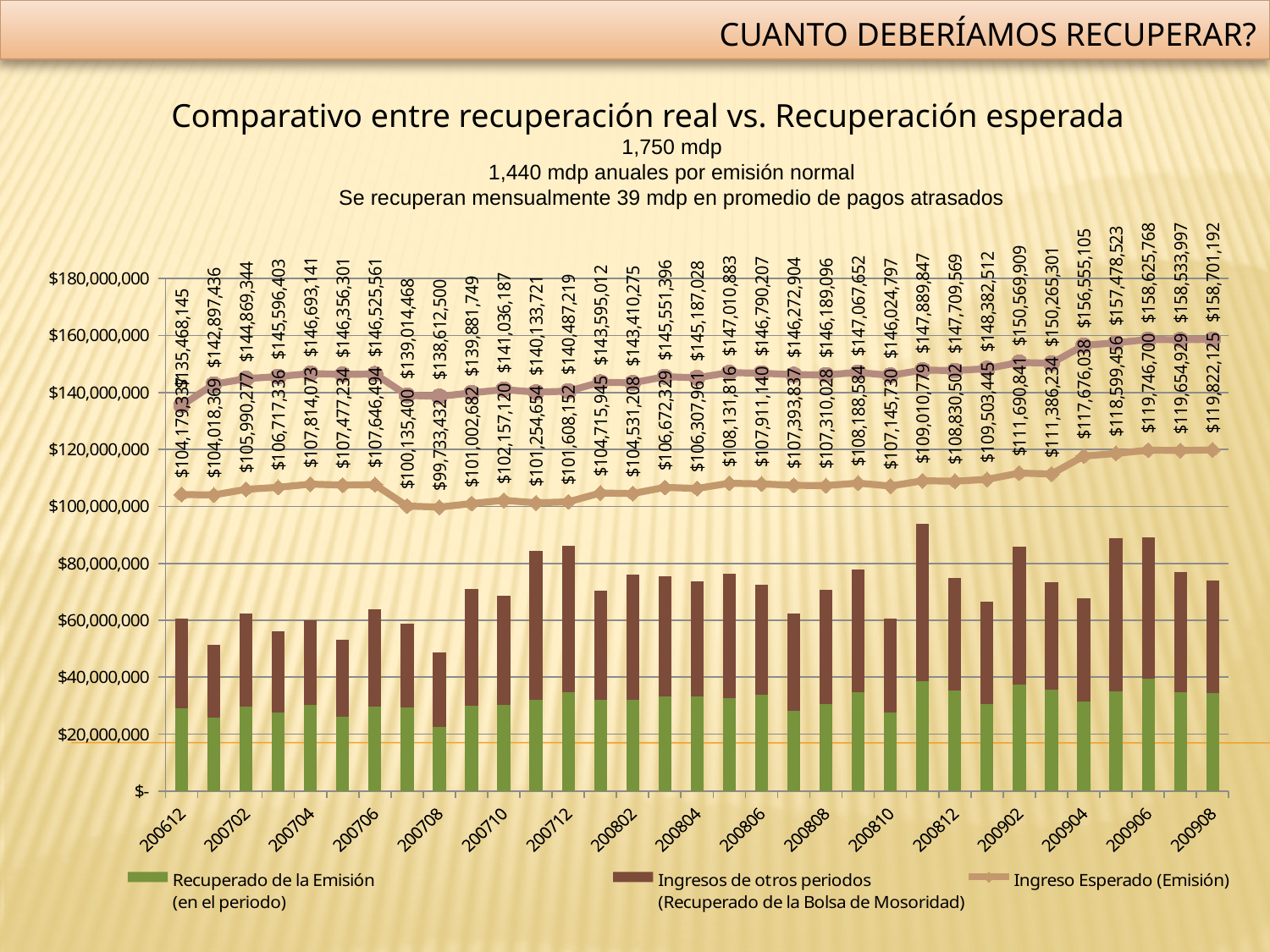
In which period is Ingreso Esperado (Emisión) lowest? 200708 What is the value of Ingreso Esperado (Emisión) for 200908? $119,822,125 How many series does the legend list? 3 What is the value of Ingreso Esperado (Emisión) for 200612? $104,179,337 Is the Ingreso Esperado (Emisión) value for 200708 greater or less than $100,000,000? less What is the difference between Ingreso Esperado (Emisión) for 200908 and for 200612? $15,642,788 What is the value of Ingreso Esperado (Emisión) for 200708? $99,733,432 What type of chart is shown on the slide? Combined stacked bar and line chart Does Ingreso Esperado (Emisión) generally rise or fall from 200612 to 200908? rise Is the total height of the stacked bar for 200812 greater or less than $80,000,000? less In which period is Ingreso Esperado (Emisión) highest? 200908 Which legend entry corresponds to the green bars? Recuperado de la Emisión (en el periodo)